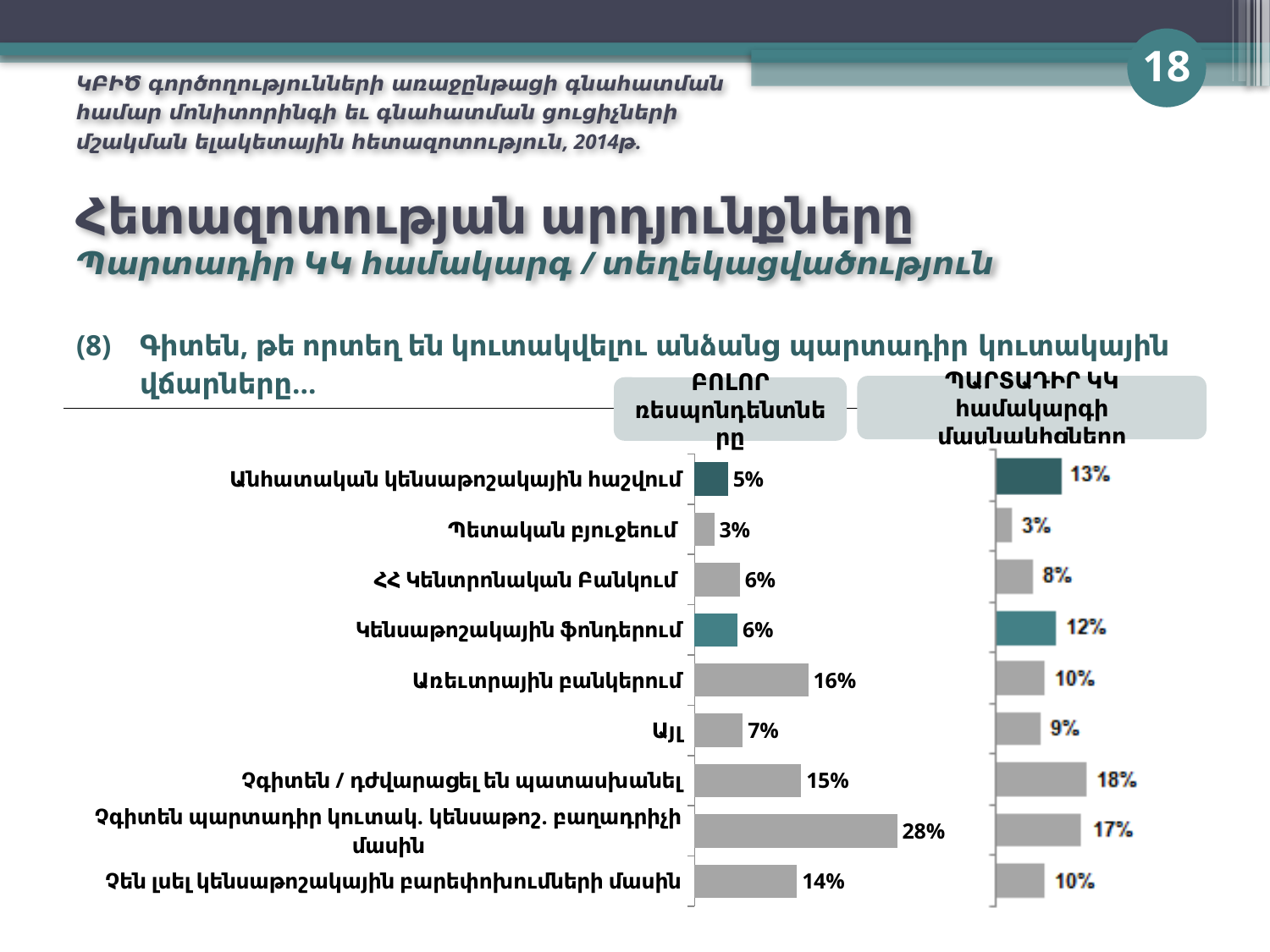
How many categories are shown in the left chart (ԲՈԼՈՐ ռեսպոնդենտները)? 9 What is the difference between the value for Կենսաթոշակային ֆոնդերում in the right chart and in the left chart? 6% In the left chart (ԲՈԼՈՐ ռեսպոնդենտները), what is the difference between Չգիտեն պարտադիր կուտակ. կենսաթոշ. բաղադրիչի մասին and Չեն լսել կենսաթոշակային բարեփոխումների մասին? 14% In the left chart (ԲՈԼՈՐ ռեսպոնդենտները), which category has the lowest value? Պետական բյուջեում Which is larger for Առևտրային բանկերում: the value in the left chart or the value in the right chart? Left chart (16%) In the right chart (ՊԱՐՏԱԴԻՐ ԿԿ համակարգի մասնակիցներ), what is the value for Անհատական կենսաթոշակային հաշվում? 13% In the left chart (ԲՈԼՈՐ ռեսպոնդենտները), what is the value for Առևտրային բանկերում? 16% In the right chart (ՊԱՐՏԱԴԻՐ ԿԿ համակարգի մասնակիցներ), which category has the highest value? Չգիտեն / դժվարացել են պատասխանել What type of chart is used on this slide? Bar chart In the right chart (ՊԱՐՏԱԴԻՐ ԿԿ համակարգի մասնակիցներ), what is the value for Այլ? 9% In the left chart (ԲՈԼՈՐ ռեսպոնդենտները), which category has the highest value? Չգիտեն պարտադիր կուտակ. կենսաթոշ. բաղադրիչի մասին In the right chart (ՊԱՐՏԱԴԻՐ ԿԿ համակարգի մասնակիցներ), which category has the lowest value? Պետական բյուջեում